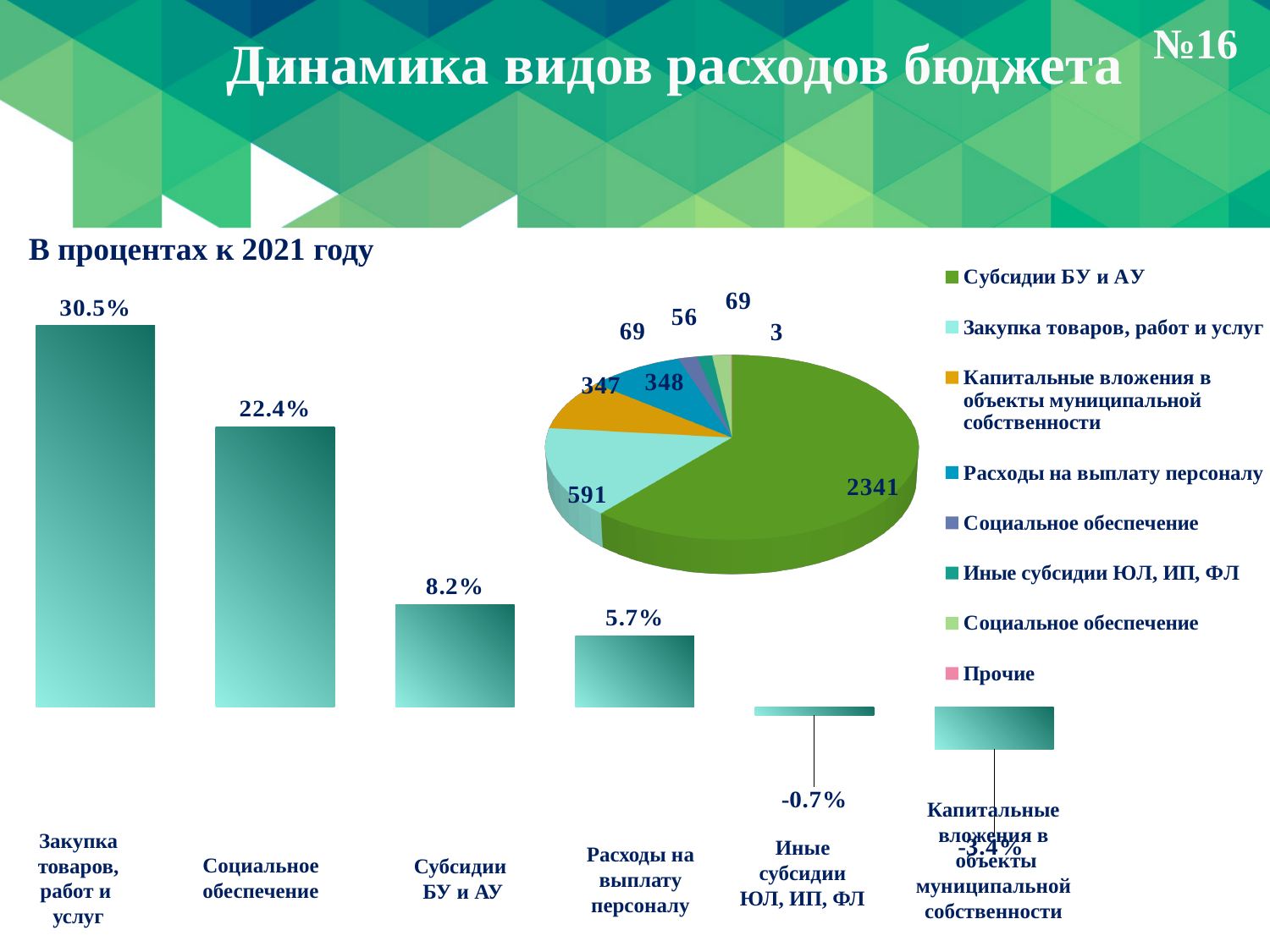
On the bar chart on the left, what is the value for Расходы на выплату персоналу? 5.7% On the pie chart, what is the value for Закупка товаров, работ и услуг? 591 How many categories are shown on the bar chart on the left? 6 On the bar chart on the left, which category has the highest value? Закупка товаров, работ и услуг On the bar chart on the left, which is larger: the value for Субсидии БУ и АУ or the value for Расходы на выплату персоналу? Субсидии БУ и АУ On the pie chart, what is the value for Субсидии БУ и АУ? 2341 On the bar chart on the left, what is the value for Закупка товаров, работ и услуг? 30.5% On the bar chart on the left, what is the difference between the values for Закупка товаров, работ и услуг and Социальное обеспечение? 8.1% On the bar chart on the left, what is the value for Капитальные вложения в объекты муниципальной собственности? -3.4% How many entries does the legend of the pie chart list? 8 What kind of chart is the chart on the right of the slide? Pie chart On the bar chart on the left, which category has the lowest value? Капитальные вложения в объекты муниципальной собственности